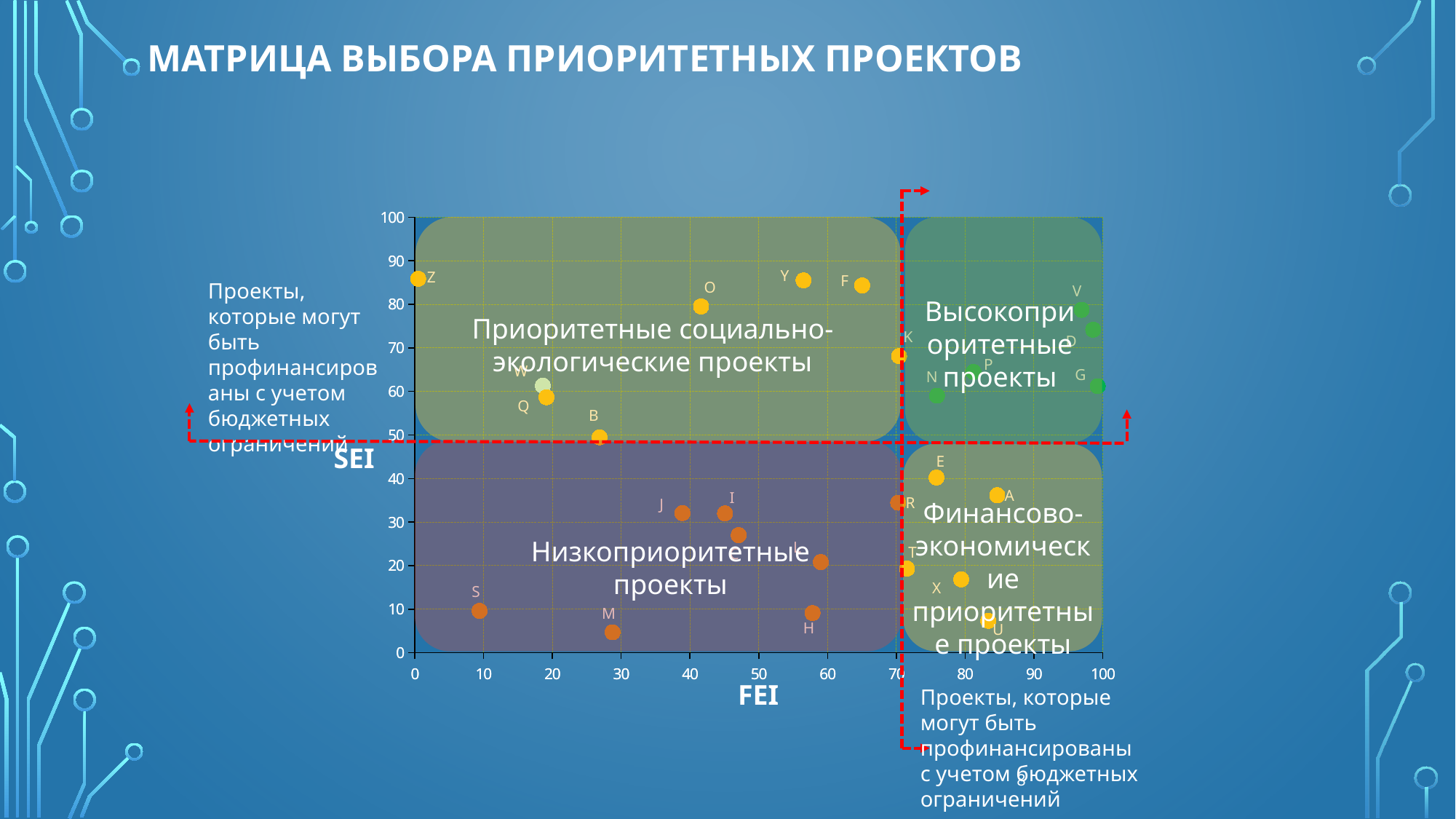
What is the title of the chart on the slide? МАТРИЦА ВЫБОРА ПРИОРИТЕТНЫХ ПРОЕКТОВ Is the SEI value for point S greater or less than 20? less Is the SEI value for point M greater or less than 10? less What label is shown on the horizontal axis of the chart? FEI Is the SEI value for point E greater or less than 50? less What kind of chart is shown on the slide? scatter chart Which point has the lowest SEI value? M Which point has the lowest FEI value? Z Which point has a higher SEI value, Y or M? Y